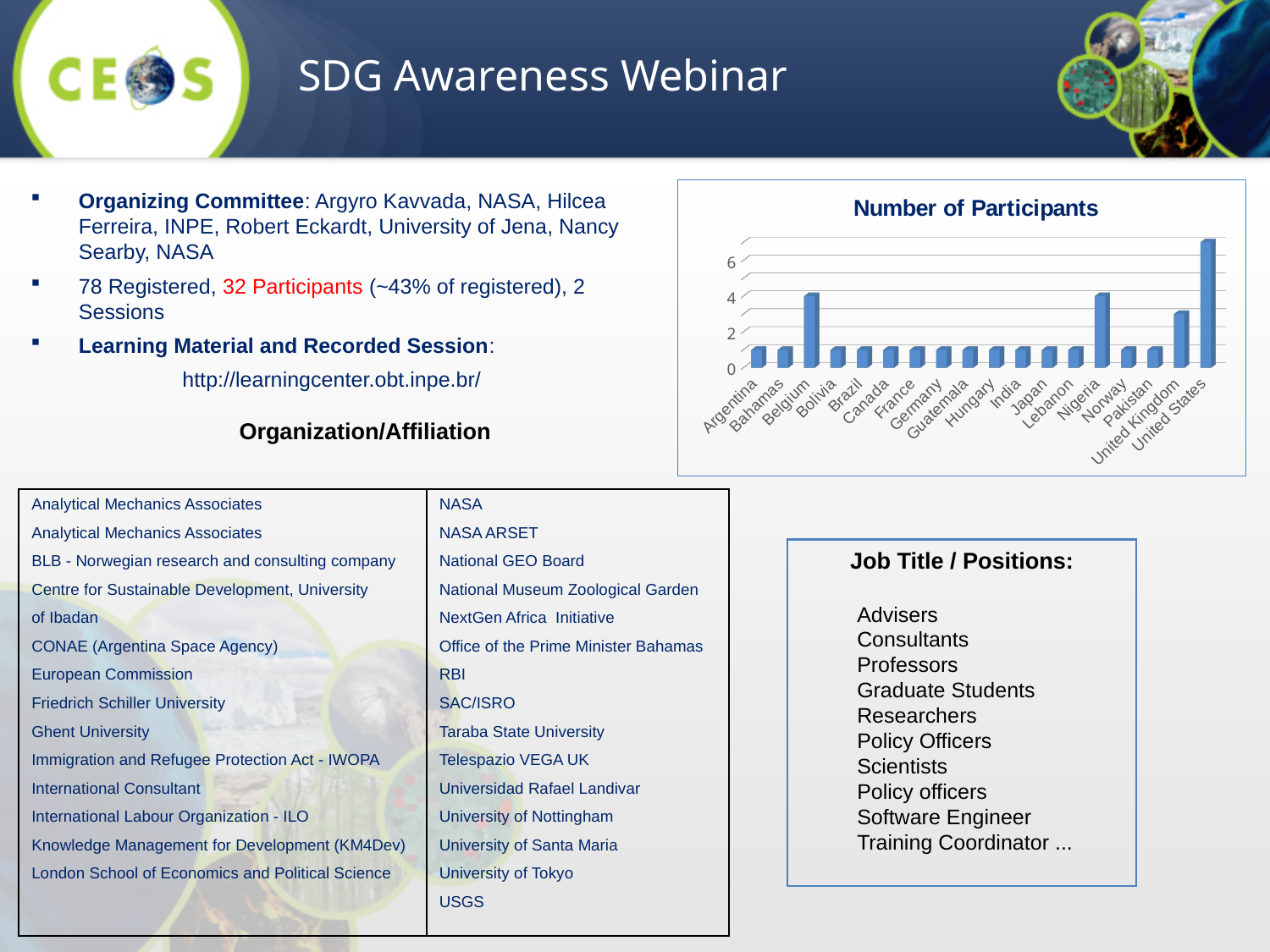
What type of chart is shown on the slide? bar chart Which country has the highest number of participants? United States Is the value for United Kingdom greater or less than 4? less Is the value for Argentina greater or less than 2? less Which has more participants, Nigeria or Japan? Nigeria Is the value for Nigeria greater or less than 2? greater Which has more participants, United States or Belgium? United States Which has more participants, United Kingdom or Brazil? United Kingdom How many countries are shown on the x axis of the chart? 18 What is the title of the chart? Number of Participants